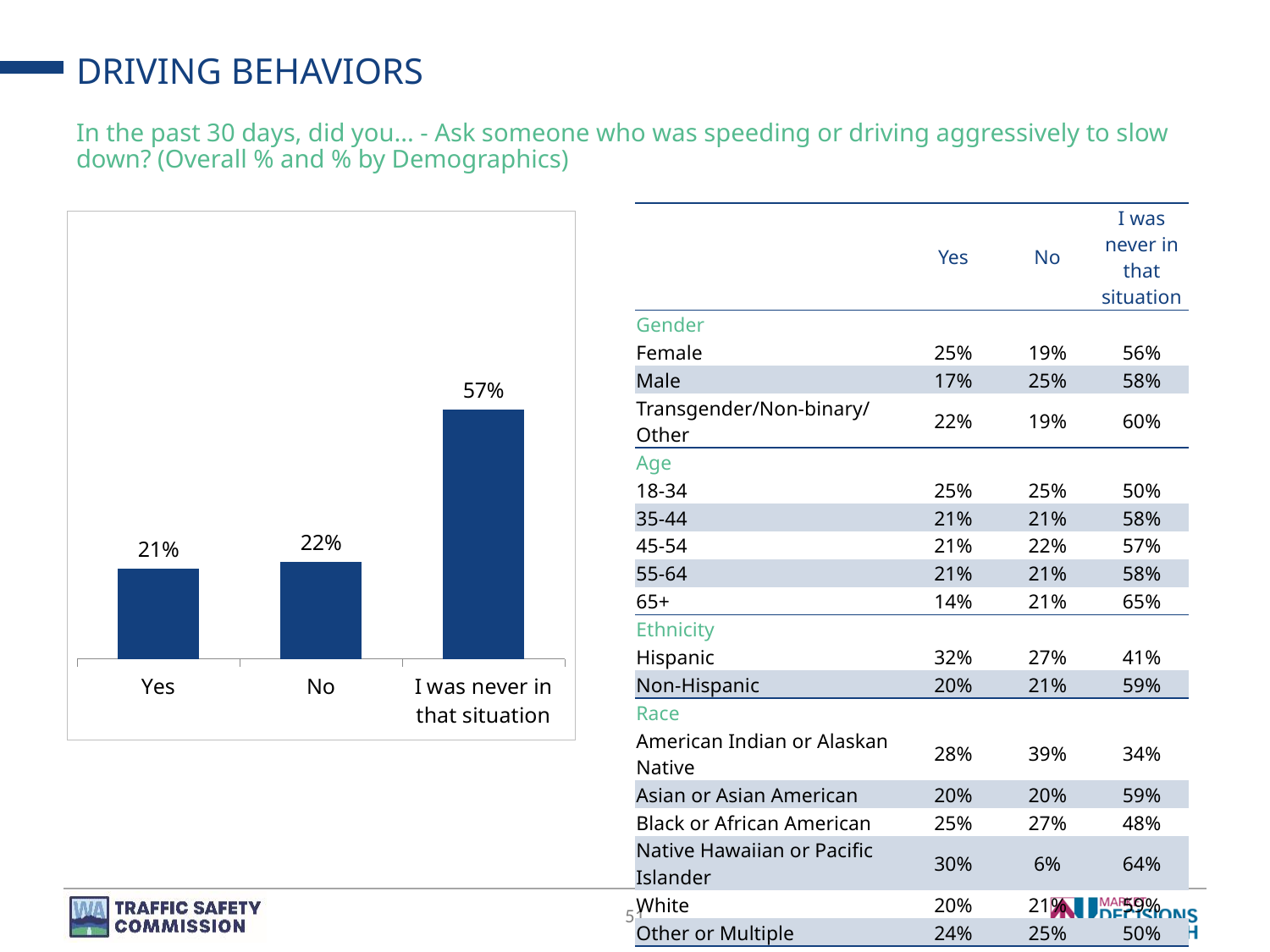
What is the value for "No" in the chart? 22% Which is larger, the value for "No" or the value for "I was never in that situation"? I was never in that situation How many bars does the chart show? 3 What kind of chart is shown on the slide? bar chart What is the value for "I was never in that situation" in the chart? 57% What is the label of the rightmost bar in the chart? I was never in that situation Which category has the lowest value in the chart? Yes What is the difference between the values for "No" and "Yes"? 1% Which category has the highest value in the chart? I was never in that situation Do the bar values rise or fall from left to right across the chart? rise What is the difference between the values for "I was never in that situation" and "Yes"? 36% What is the value for "Yes" in the chart? 21%